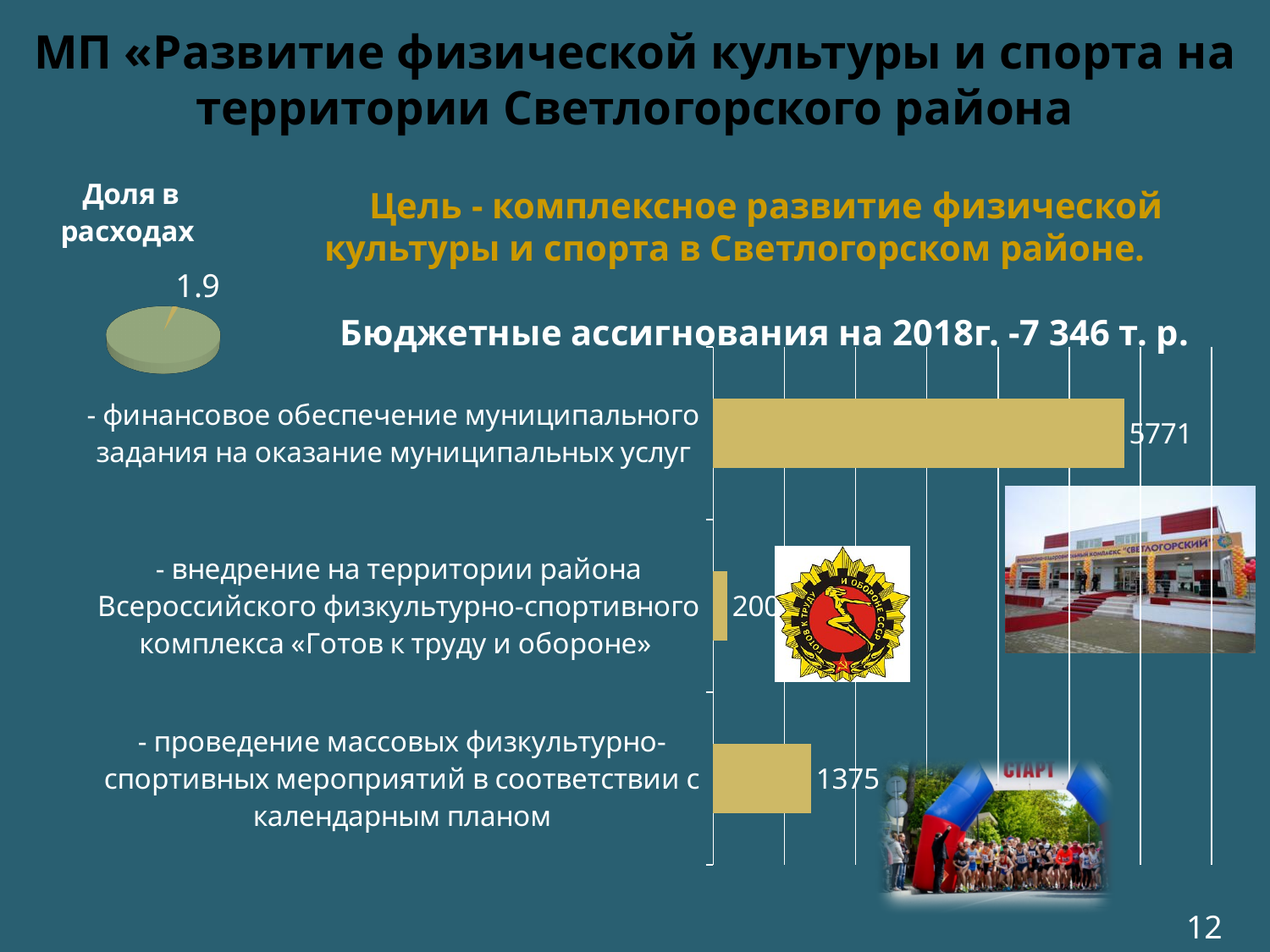
In the bar chart, what is the difference between the value for mass sports events and the value for the 'Готов к труду и обороне' complex? 1175 What kind of chart is used to show the budget allocations for 2018? bar chart In the bar chart, what is the difference between the value for the municipal task (5771) and the value for mass sports events (1375)? 4396 In the bar chart, what is the value for implementing the 'Готов к труду и обороне' complex in the district? 200 What is the title of the bar chart on the slide? Бюджетные ассигнования на 2018г. -7 346 т. р. What value is labelled on the small pie chart under 'Доля в расходах'? 1.9 In the bar chart, which category has the highest value? финансовое обеспечение муниципального задания на оказание муниципальных услуг In the bar chart, what is the value for financial support of the municipal task for providing municipal services (финансовое обеспечение муниципального задания)? 5771 In the bar chart, which is larger: the value for mass sports events or the value for the 'Готов к труду и обороне' complex? mass sports events (1375) In the bar chart, what is the value for holding mass physical culture and sports events according to the calendar plan? 1375 In the bar chart, which category has the lowest value? внедрение на территории района Всероссийского физкультурно-спортивного комплекса «Готов к труду и обороне» How many categories does the bar chart show? 3